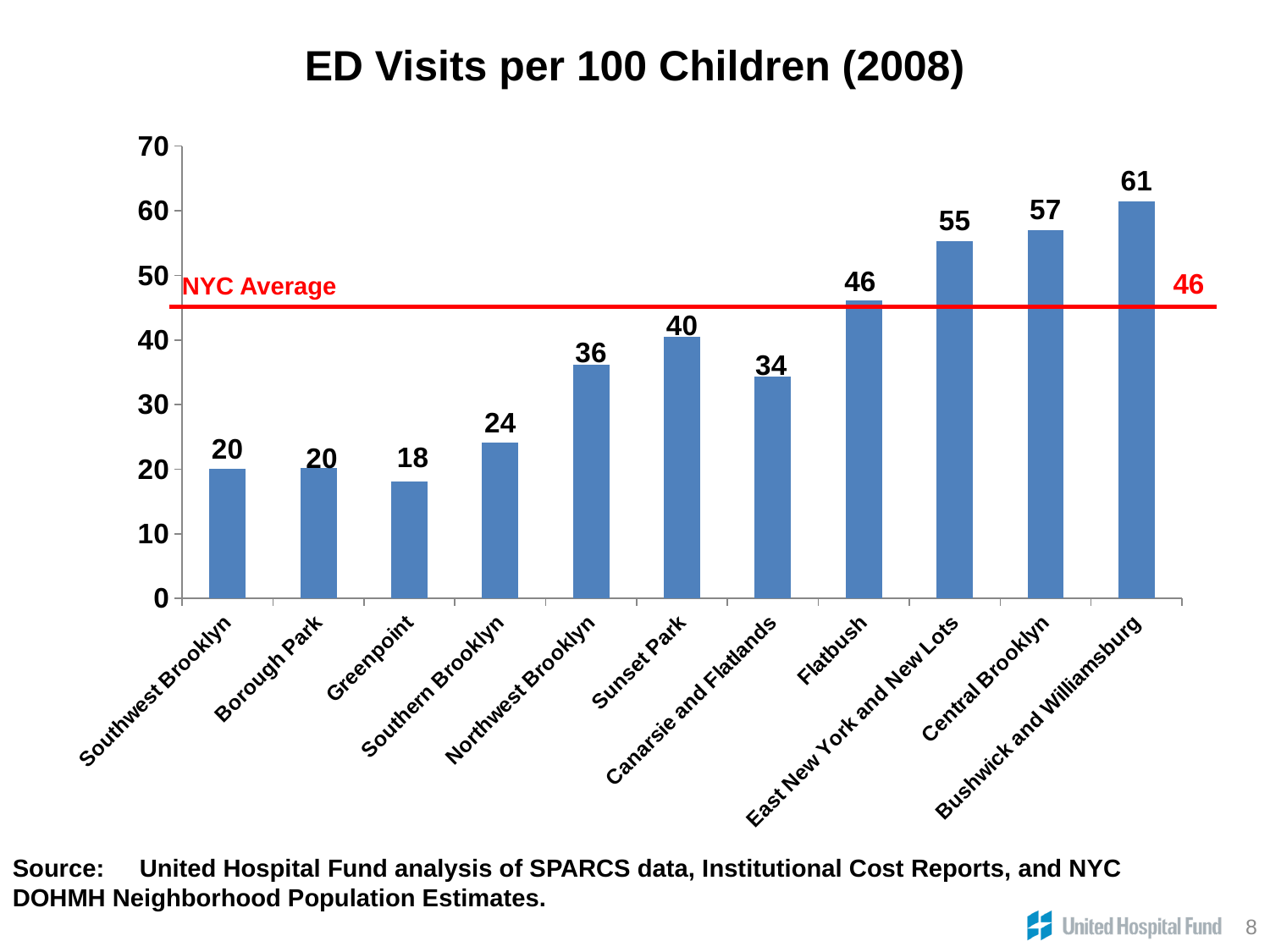
Which neighborhood has the lowest ED visits per 100 children? Greenpoint What is the value for Flatbush? 46 Which neighborhood has the highest ED visits per 100 children? Bushwick and Williamsburg What is the difference between the values for Central Brooklyn and Southern Brooklyn? 33 What is the value for Greenpoint? 18 How many neighborhoods are shown on the chart? 11 What is the value for Sunset Park? 40 What value does the red NYC Average line mark? 46 What is the value for East New York and New Lots? 55 Which is larger, the value for Northwest Brooklyn or the value for Canarsie and Flatlands? Northwest Brooklyn What kind of chart is shown on the slide? Bar chart What is the title of the chart? ED Visits per 100 Children (2008)